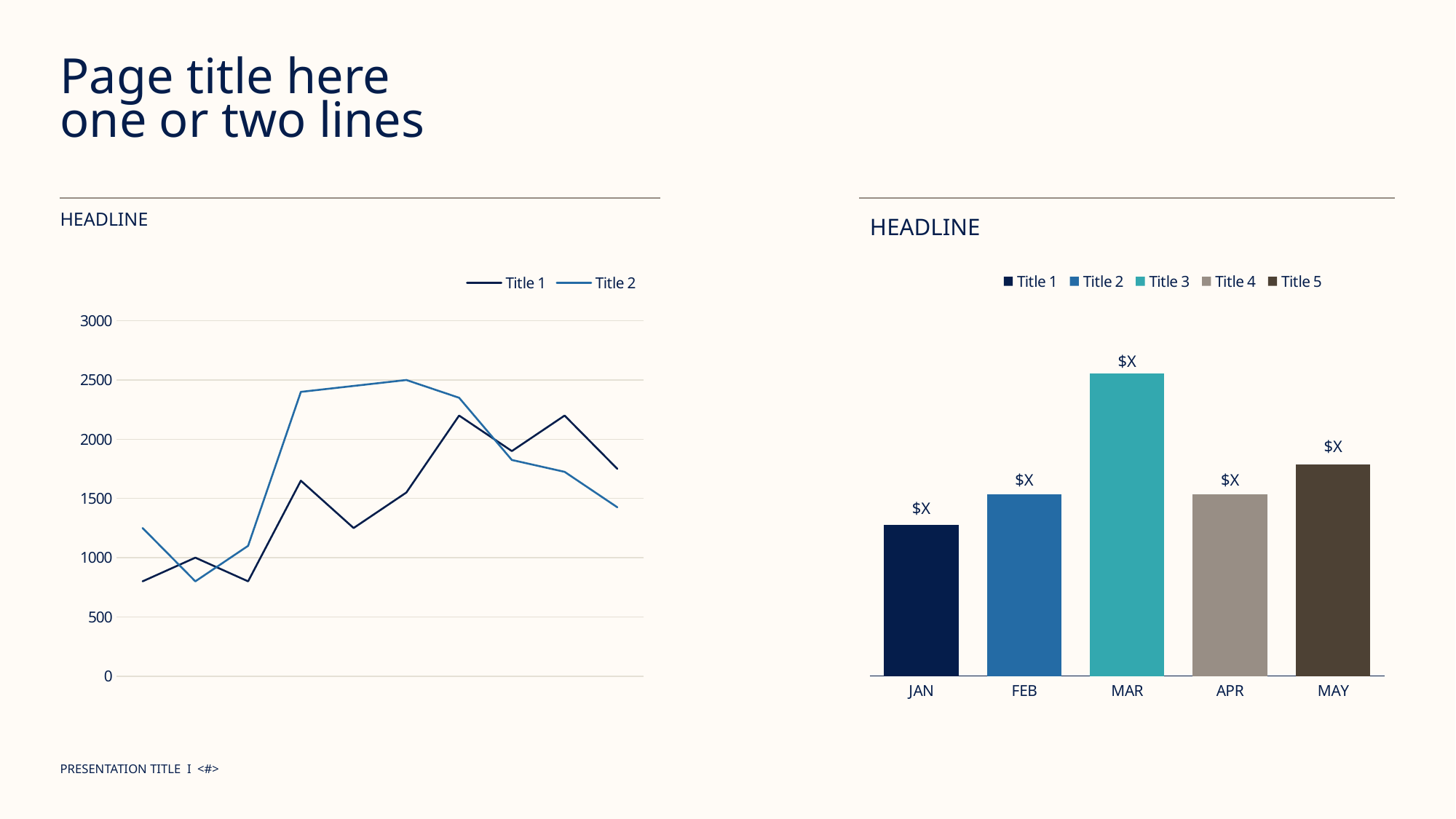
How many series does the legend of the left chart list? 2 On the left chart, what is the highest value shown on the vertical axis? 3000 On the right chart, which month has the shortest bar? JAN On the left chart, is the highest value of the Title 1 line greater or less than 2500? less On the right chart, what data label is printed above each bar? $X On the left chart, which series reaches the higher peak, Title 1 or Title 2? Title 2 What kind of chart is the chart on the right side of the slide? bar chart How many categories are shown on the x axis of the right chart? 5 What kind of chart is the chart on the left side of the slide? line chart On the right chart, which month has the tallest bar? MAR How many series does the legend of the right chart list? 5 On the right chart, which bar is taller, MAY or APR? MAY